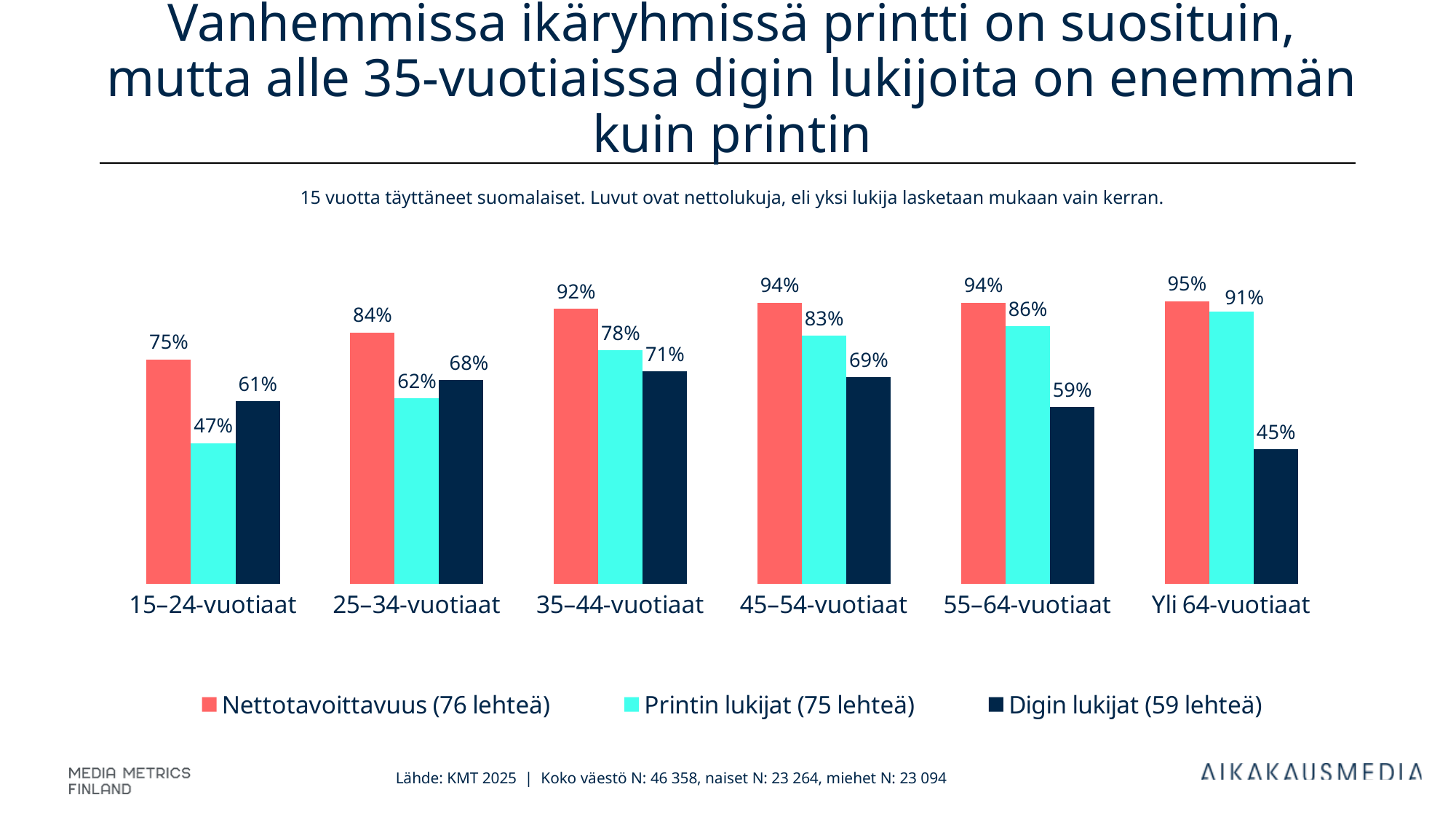
How many age groups are shown on the x axis? 6 Which colour represents Printin lukijat (75 lehteä) in the chart? Turquoise (light cyan) What is the difference between Printin lukijat and Digin lukijat in the Yli 64-vuotiaat age group? 46 percentage points Do the Digin lukijat (59 lehteä) values rise or fall from the 35–44-vuotiaat group to the Yli 64-vuotiaat group? Fall How many series does the legend list? 3 Which age group has the highest Nettotavoittavuus (76 lehteä) value? Yli 64-vuotiaat Which age group has the lowest Printin lukijat (75 lehteä) value? 15–24-vuotiaat In the 25–34-vuotiaat age group, which is larger: Printin lukijat or Digin lukijat? Digin lukijat What is the value for Printin lukijat (75 lehteä) in the 15–24-vuotiaat age group? 47% What is the value for Digin lukijat (59 lehteä) in the Yli 64-vuotiaat age group? 45% What kind of chart is shown on the slide? Bar chart What is the Nettotavoittavuus (76 lehteä) value for 35–44-vuotiaat? 92%